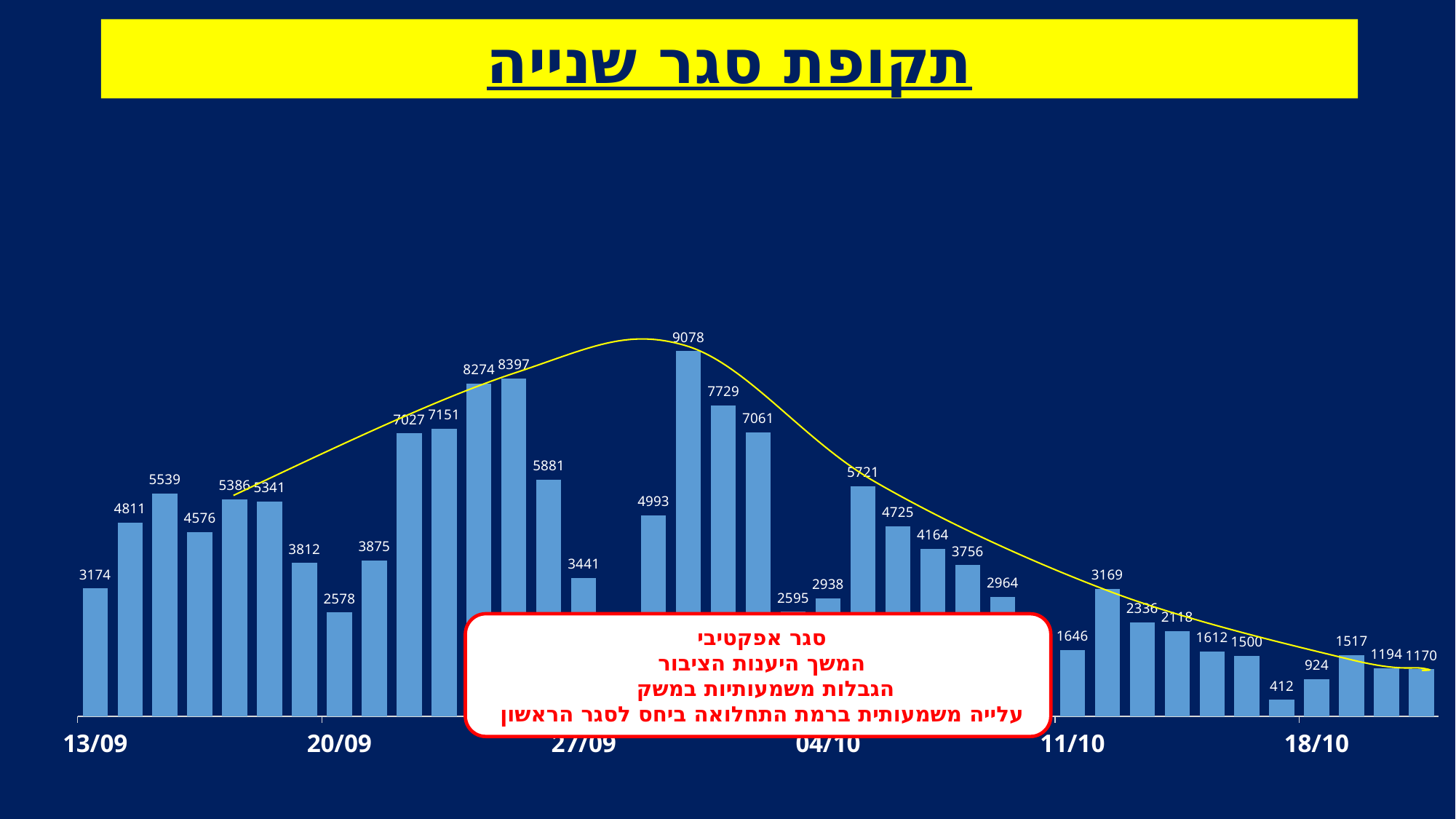
What colour is the smoothed line drawn over the bars? yellow Which is larger, the bar at 13/09 or the bar at 18/10? 13/09 What is the value of the bar at 27/09? 3441 Do the bar values generally rise or fall from 04/10 to the end of the chart? fall What is the value of the bar at 13/09? 3174 What is the value of the bar at 18/10? 924 What is the highest value labelled on any bar in the chart? 9078 What is the value of the bar at 20/09? 2578 What is the value of the bar at 11/10? 1646 What is the lowest value labelled on any bar in the chart? 412 What kind of chart is shown on the slide? combination bar and line chart What is the difference between the highest bar (9078) and the lowest bar (412)? 8666